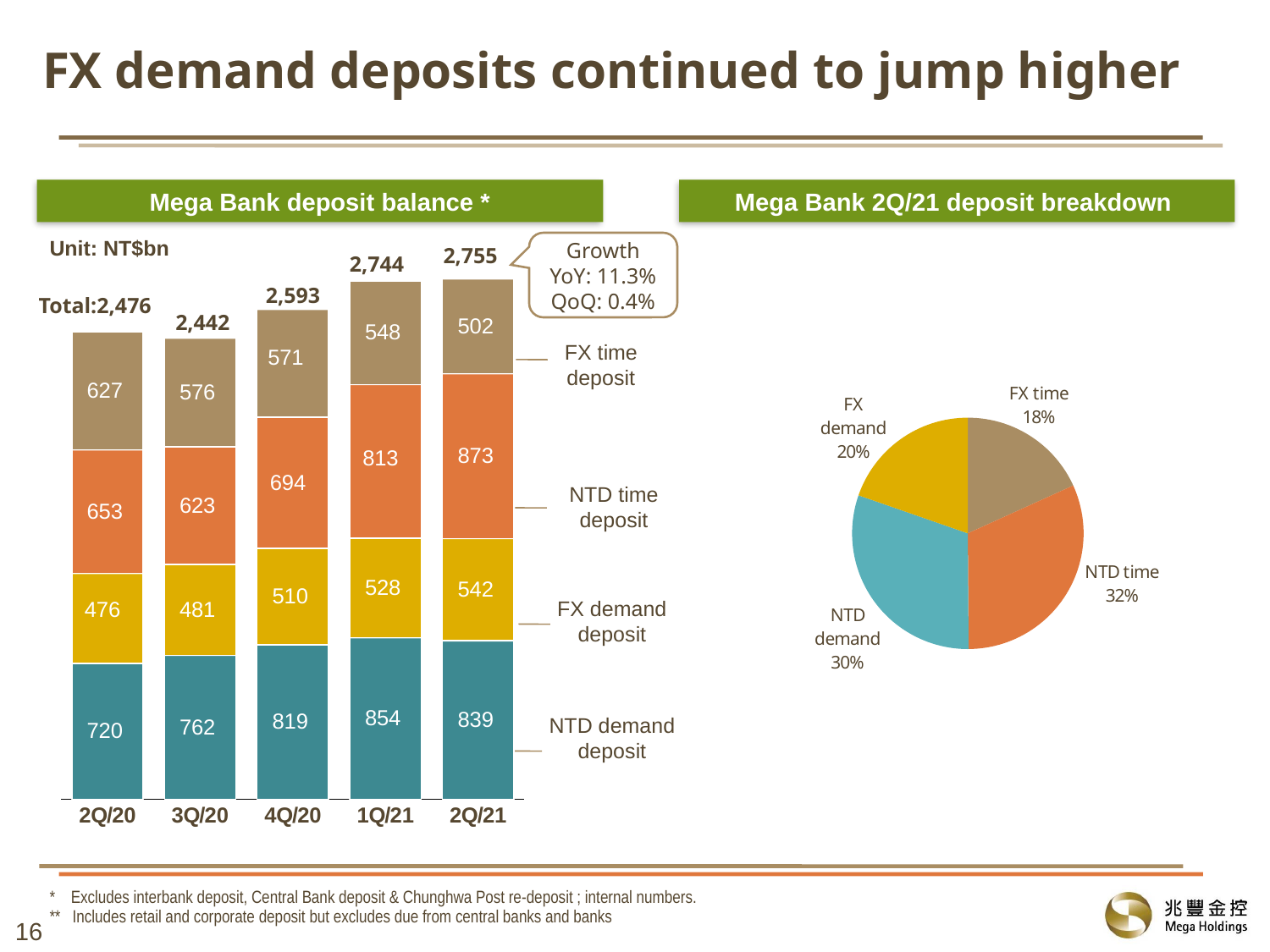
In the Mega Bank deposit balance chart, which quarter has the highest total deposit balance? 2Q/21 In the Mega Bank deposit balance chart, which quarter has the lowest total deposit balance? 3Q/20 What kind of chart is the Mega Bank deposit balance chart? stacked bar chart In the Mega Bank 2Q/21 deposit breakdown pie chart, which category has the smallest share? FX time In the Mega Bank deposit balance chart, does the FX time deposit value rise or fall from 2Q/20 to 2Q/21? fall In the Mega Bank deposit balance chart, what is the NTD demand deposit value for 2Q/21? 839 In the Mega Bank deposit balance chart, what is the FX time deposit value for 4Q/20? 571 In the Mega Bank deposit balance chart, which is larger: the FX demand deposit for 2Q/20 or for 2Q/21? 2Q/21 In the Mega Bank 2Q/21 deposit breakdown pie chart, what share is NTD time deposit? 32% In the Mega Bank deposit balance chart, how many quarters are shown on the x axis? 5 In the Mega Bank deposit balance chart, what is the difference between the NTD time deposit values for 2Q/21 and 1Q/21? 60 In the Mega Bank deposit balance chart, what is the total deposit balance for 1Q/21? 2,744